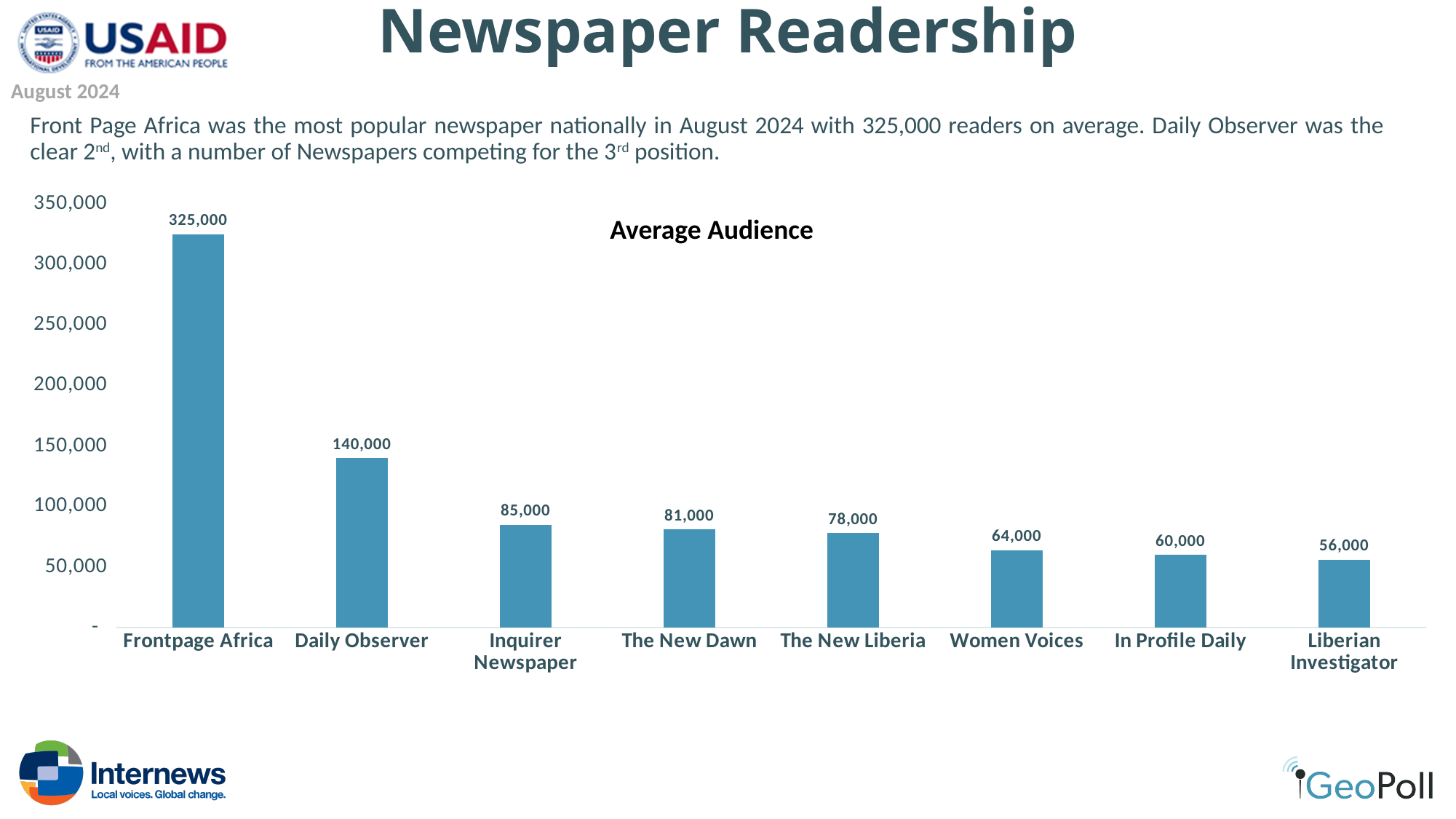
How many newspapers are shown in the chart? 8 What is the average audience for The New Liberia? 78,000 Which has a larger average audience, Women Voices or In Profile Daily? Women Voices What is the average audience for Liberian Investigator? 56,000 What is the title of the chart? Average Audience Which newspaper has the highest average audience? Frontpage Africa Which newspaper has the lowest average audience? Liberian Investigator What is the difference in average audience between Frontpage Africa and Daily Observer? 185,000 What is the average audience for Frontpage Africa? 325,000 What kind of chart is used to show the average audience? Bar chart What is the difference in average audience between Inquirer Newspaper and The New Dawn? 4,000 What is the average audience for Daily Observer? 140,000